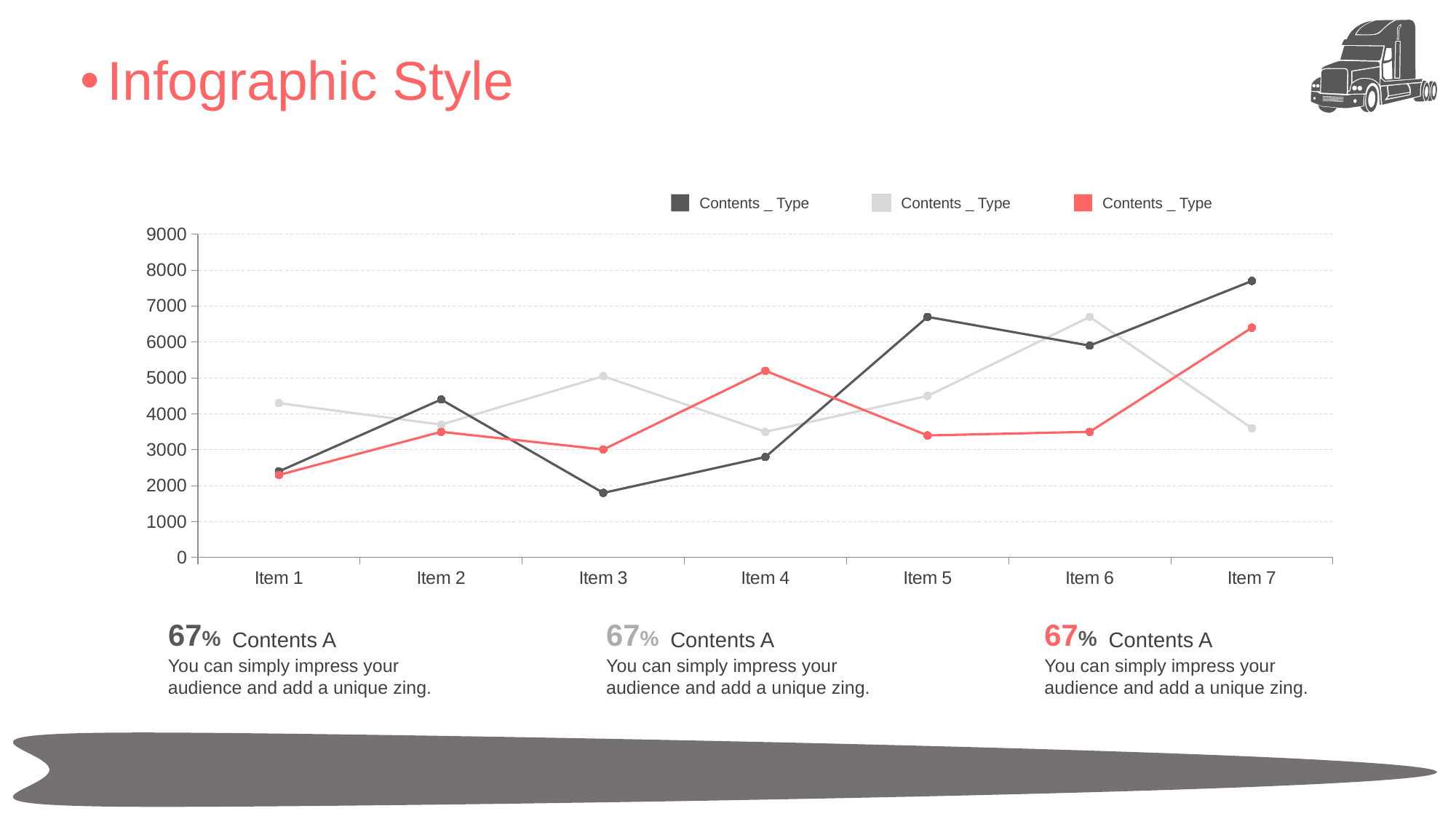
Is the value of the dark grey line at Item 7 greater or less than 7000? greater Is the value of the dark grey line at Item 3 greater or less than 2000? less At which item does the light grey line reach its highest value? Item 6 At which item does the dark grey line reach its lowest value? Item 3 What kind of chart is shown on the slide? line chart What label is shown for each of the three legend entries? Contents _ Type At which item does the dark grey line reach its highest value? Item 7 At Item 4, which line has the larger value, the red line or the dark grey line? the red line At which item does the red line reach its highest value? Item 7 Is the value of the red line at Item 4 greater or less than 4000? greater How many series does the legend list? 3 How many items are plotted along the x axis? 7